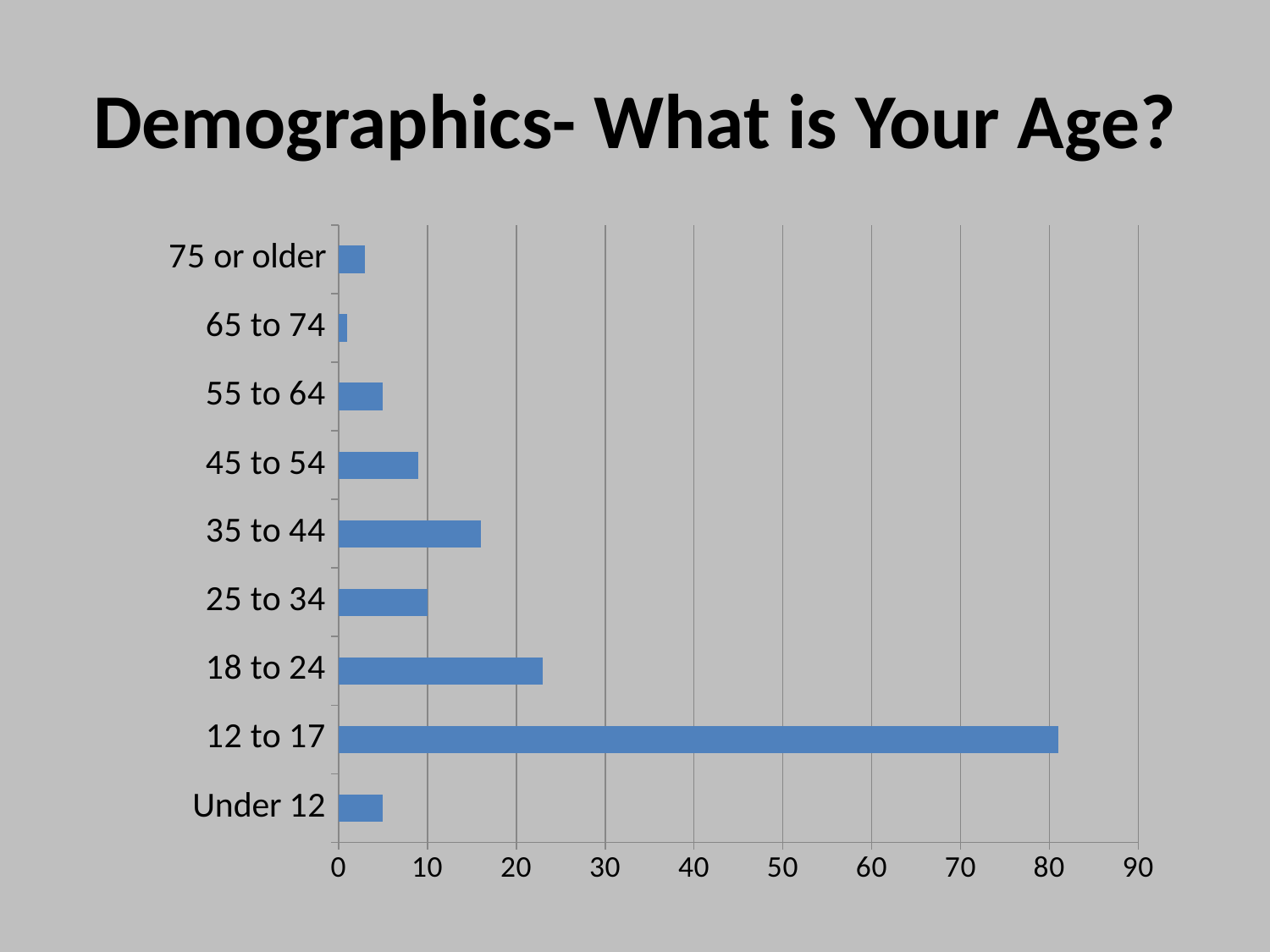
Is the value for 35 to 44 greater or less than 20? less Which has a larger value, 45 to 54 or 55 to 64? 45 to 54 Is the value for 75 or older greater or less than 10? less What is the highest value shown on the horizontal axis? 90 Is the value for 18 to 24 greater or less than 20? greater Which has a larger value, 18 to 24 or 35 to 44? 18 to 24 How many age categories are shown in the chart? 9 What type of chart is shown on the slide? bar chart Which age category has the lowest value? 65 to 74 What is the title of the chart? Demographics- What is Your Age? Which age category has the highest value? 12 to 17